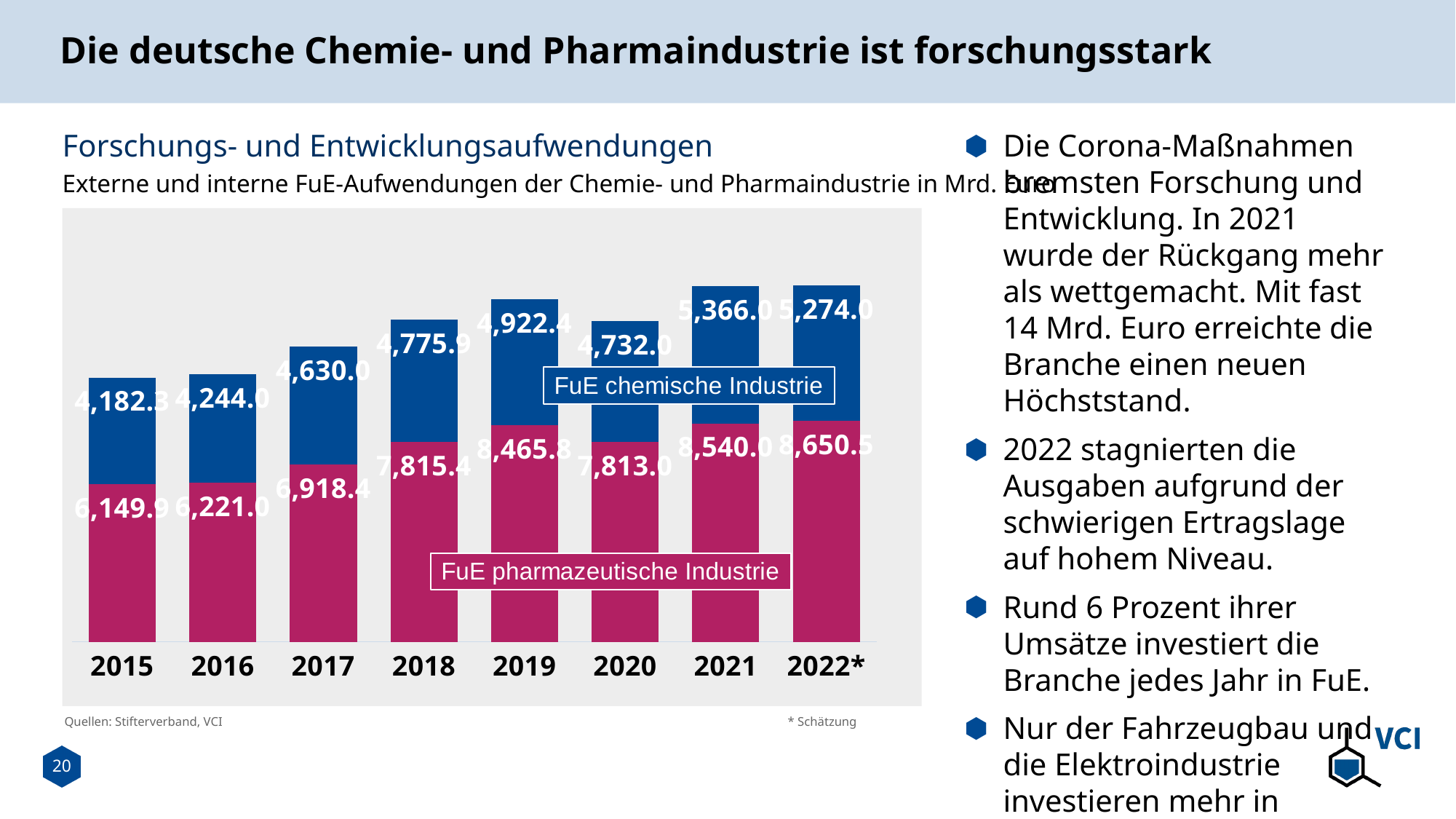
What is the total of the stacked bar for 2021? 13,906.0 In which year is the value for FuE pharmazeutische Industrie lowest? 2015 What is the value for FuE pharmazeutische Industrie in 2015? 6,149.9 What is the value for FuE pharmazeutische Industrie in 2022*? 8,650.5 What is the difference between the FuE pharmazeutische Industrie values for 2021 and 2020? 727.0 What is the value for FuE chemische Industrie in 2019? 4,922.4 What kind of chart is shown on the slide? Stacked bar chart How many series does the chart show? 2 Which is larger: the FuE chemische Industrie value in 2020 or in 2019? 2019 Which series is shown in blue in the chart? FuE chemische Industrie In which year is the value for FuE chemische Industrie highest? 2021 How many years are shown on the x axis of the chart? 8